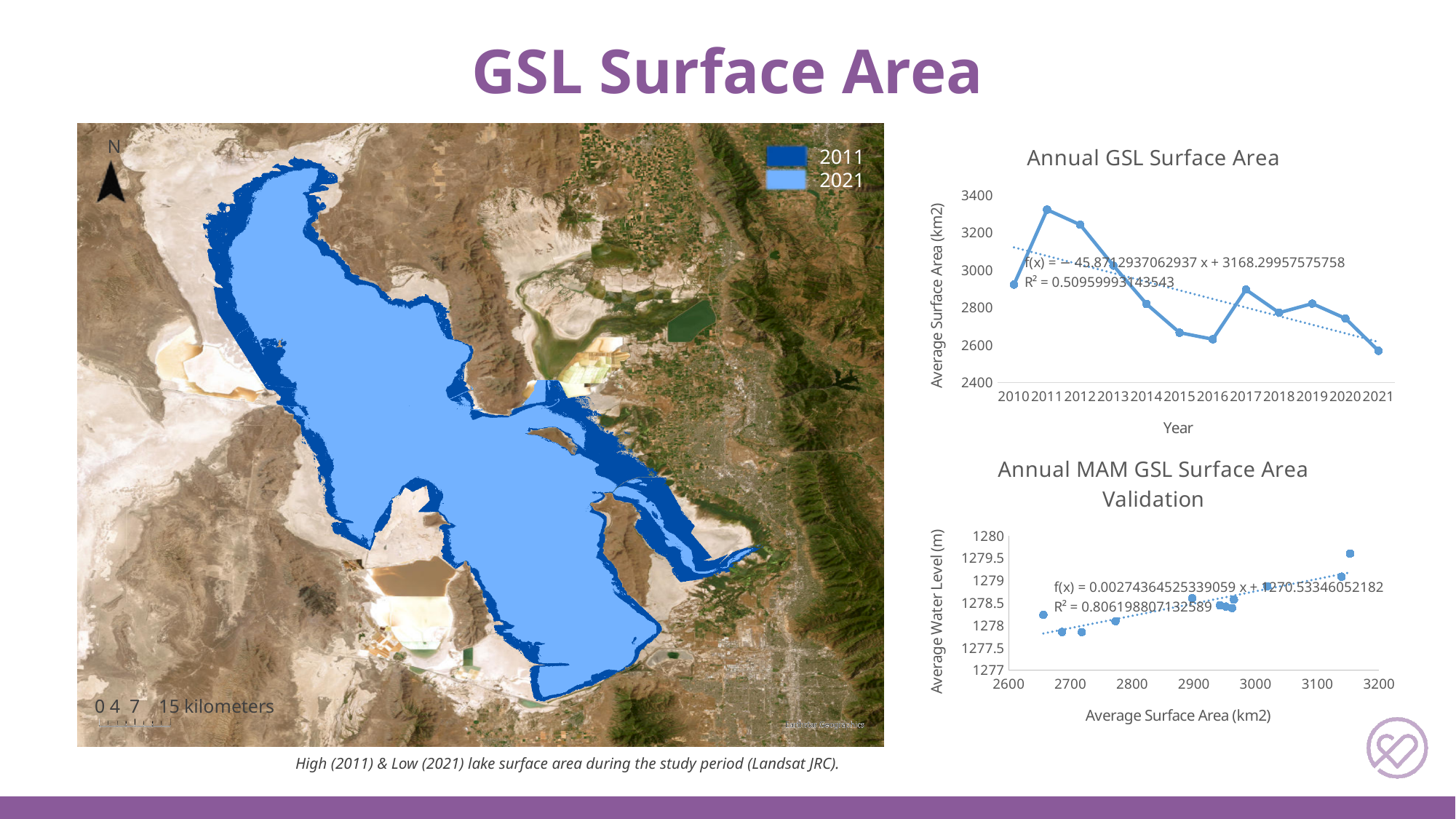
How many years are plotted in the 'Annual GSL Surface Area' chart? 12 In the 'Annual GSL Surface Area' chart, does the average surface area overall rise or fall from 2011 to 2021? fall In the 'Annual GSL Surface Area' chart, which year has the lowest average surface area? 2021 In the 'Annual MAM GSL Surface Area Validation' chart, does average water level rise or fall as average surface area increases? rise In the 'Annual GSL Surface Area' chart, is the value for 2015 greater or less than 2800? less In the 'Annual GSL Surface Area' chart, which year has the larger value, 2012 or 2013? 2012 In the 'Annual GSL Surface Area' chart, is the value for 2011 greater or less than 3200? greater In the 'Annual GSL Surface Area' chart, is the value for 2021 greater or less than 2600? less What is the x-axis title of the 'Annual GSL Surface Area' chart? Year What kind of chart is the 'Annual GSL Surface Area' chart? line chart What kind of chart is the 'Annual MAM GSL Surface Area Validation' chart? scatter chart In the 'Annual GSL Surface Area' chart, which year has the highest average surface area? 2011